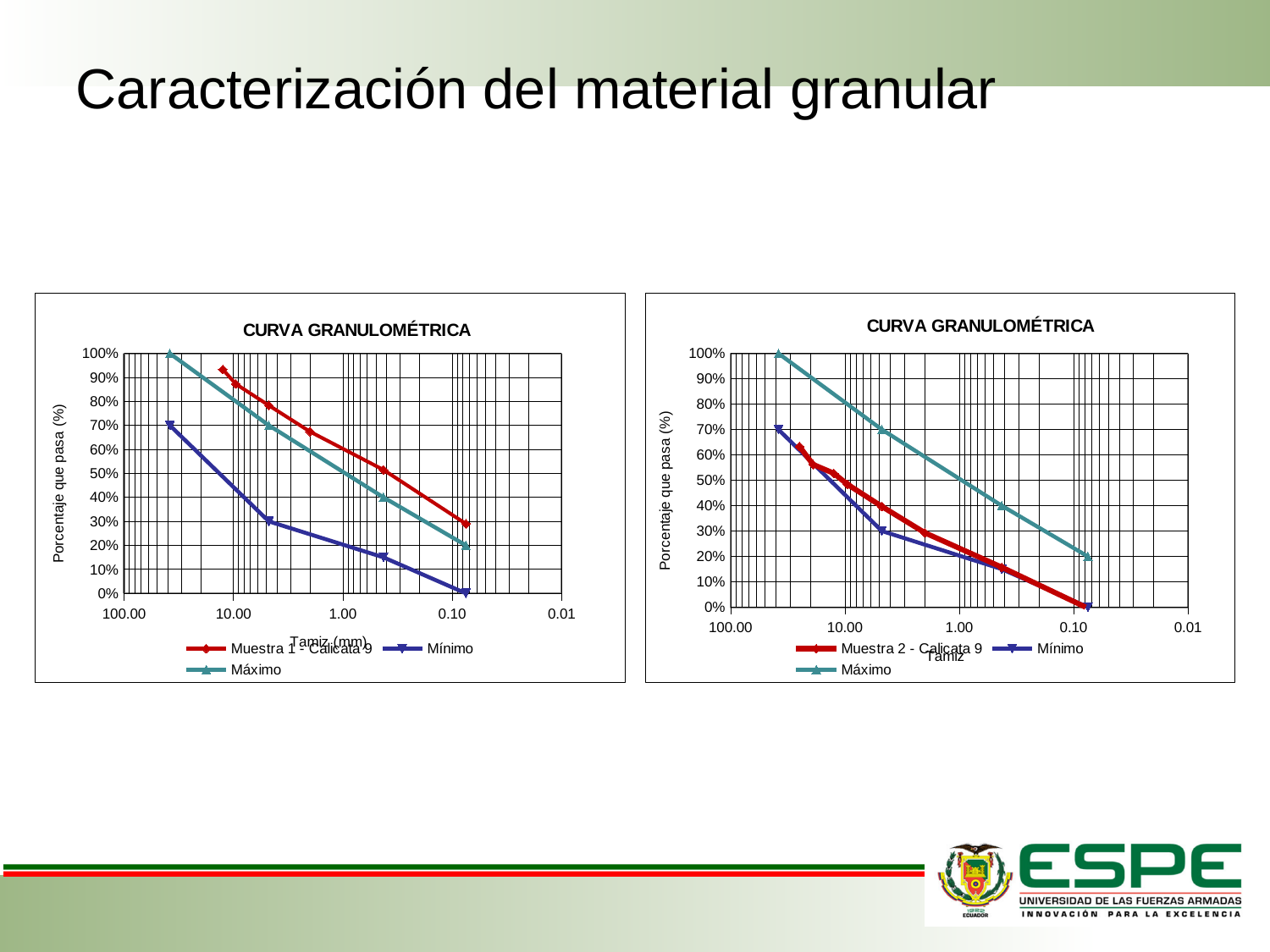
In the left chart, is the value of the rightmost point of Muestra 1 - Calicata 9 greater or less than 20%? greater In the right chart, at a sieve size of 1.00 mm, which series has the higher value: Máximo or Muestra 2 - Calicata 9? Máximo How many series does the legend of the right chart list? 3 In the left chart, do the values of the Máximo series rise or fall from left to right along the x axis? Fall In the left chart, at a sieve size of 1.00 mm, which series has the higher value: Muestra 1 - Calicata 9 or Mínimo? Muestra 1 - Calicata 9 In the right chart, do the values of the Muestra 2 - Calicata 9 series rise or fall from left to right along the x axis? Fall In the left chart, what is the highest value reached by the Máximo series? 100% In the right chart, what is the title of the vertical axis? Porcentaje que pasa (%) In the right chart, what is the lowest value reached by the Mínimo series? 0% How many series does the legend of the left chart list? 3 What kind of chart is the left chart titled CURVA GRANULOMÉTRICA? Line chart In the left chart, which series is listed first in the legend? Muestra 1 - Calicata 9